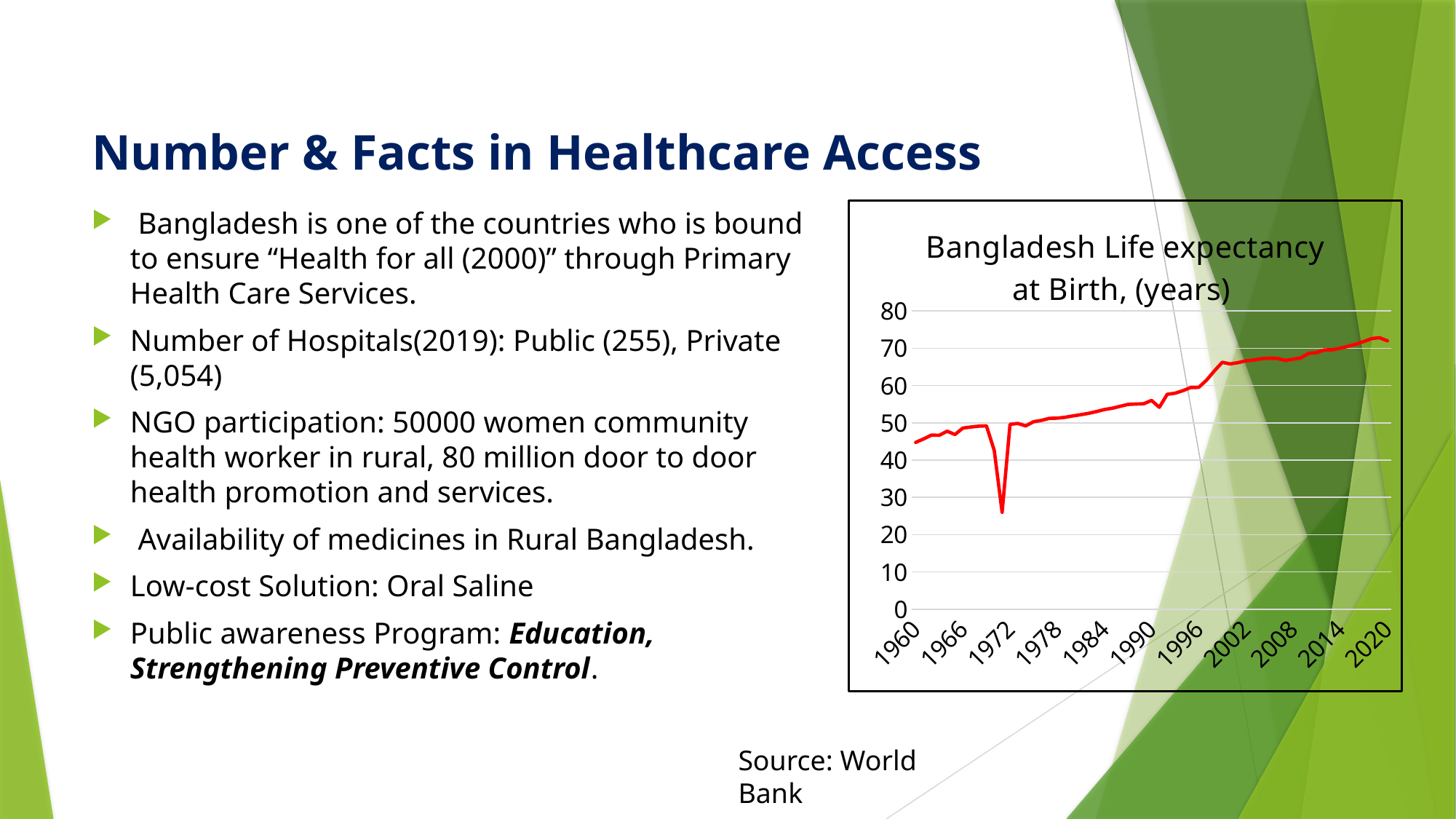
Is the value for 2020 greater or less than 70? greater Overall, do the values in the chart rise or fall from 1960 to 2020? rise Is the value for 1990 greater or less than 50? greater Is the value for 1960 greater or less than 50? less Which year has the larger value, 1978 or 2002? 2002 How many year labels are shown on the x axis? 11 What kind of chart is shown on the slide? line chart What is the source cited for the chart data? World Bank What is the title of the chart? Bangladesh Life expectancy at Birth, (years)